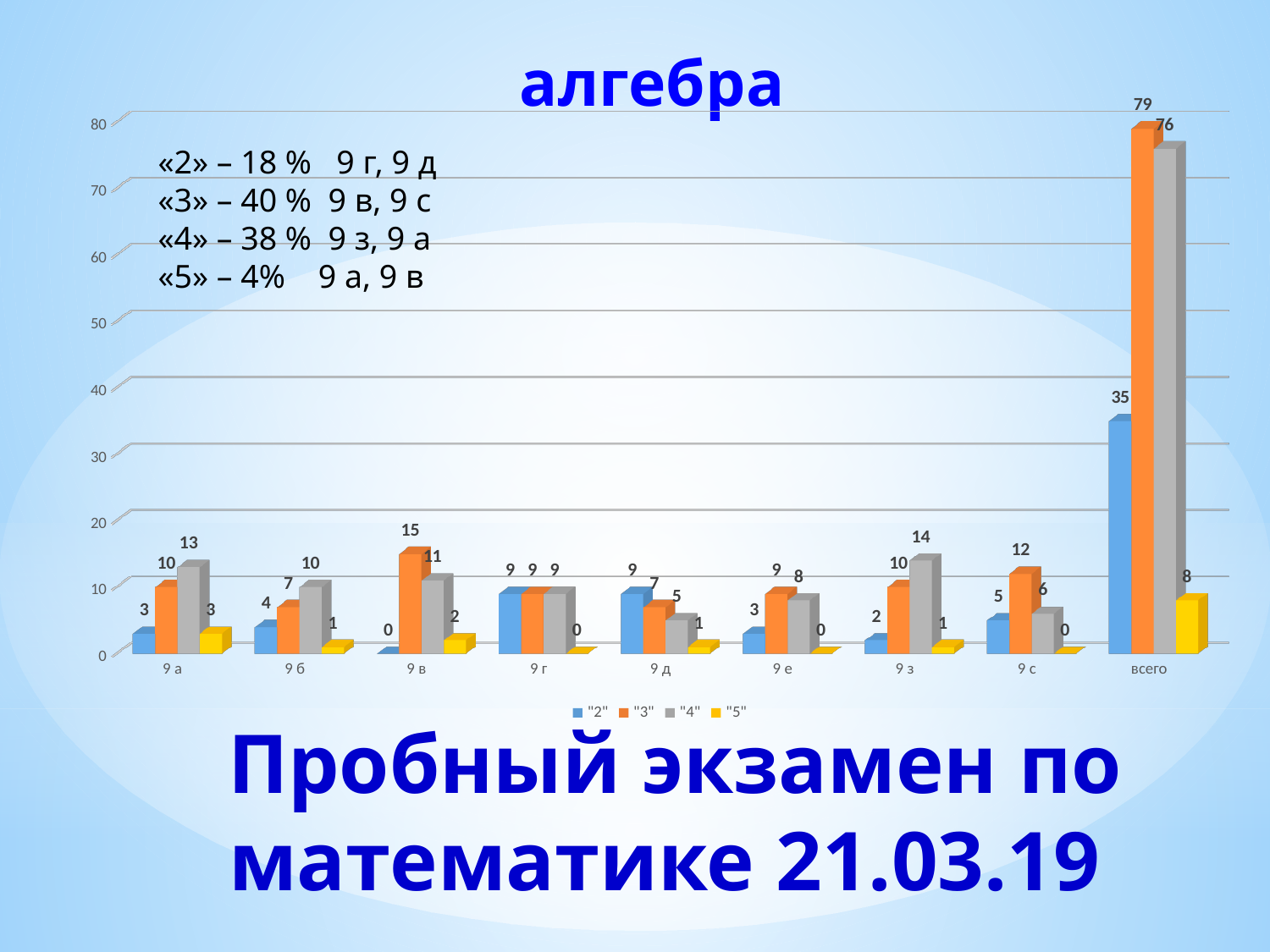
What is the value of series "2" for всего? 35 Is the value of series "3" for всего greater or less than 70? greater How many series does the legend list? 4 What kind of chart is shown on the slide? bar chart What is the difference between series "3" and series "4" for всего? 3 Excluding всего, which category has the lowest value for series "2"? 9 в Which category has the highest value for series "5"? всего Which is larger for 9 с: series "3" or series "4"? series "3" What is the title of the chart? алгебра What is the value of series "3" for 9 в? 15 What is the value of series "4" for 9 з? 14 How many categories are shown on the x axis? 9